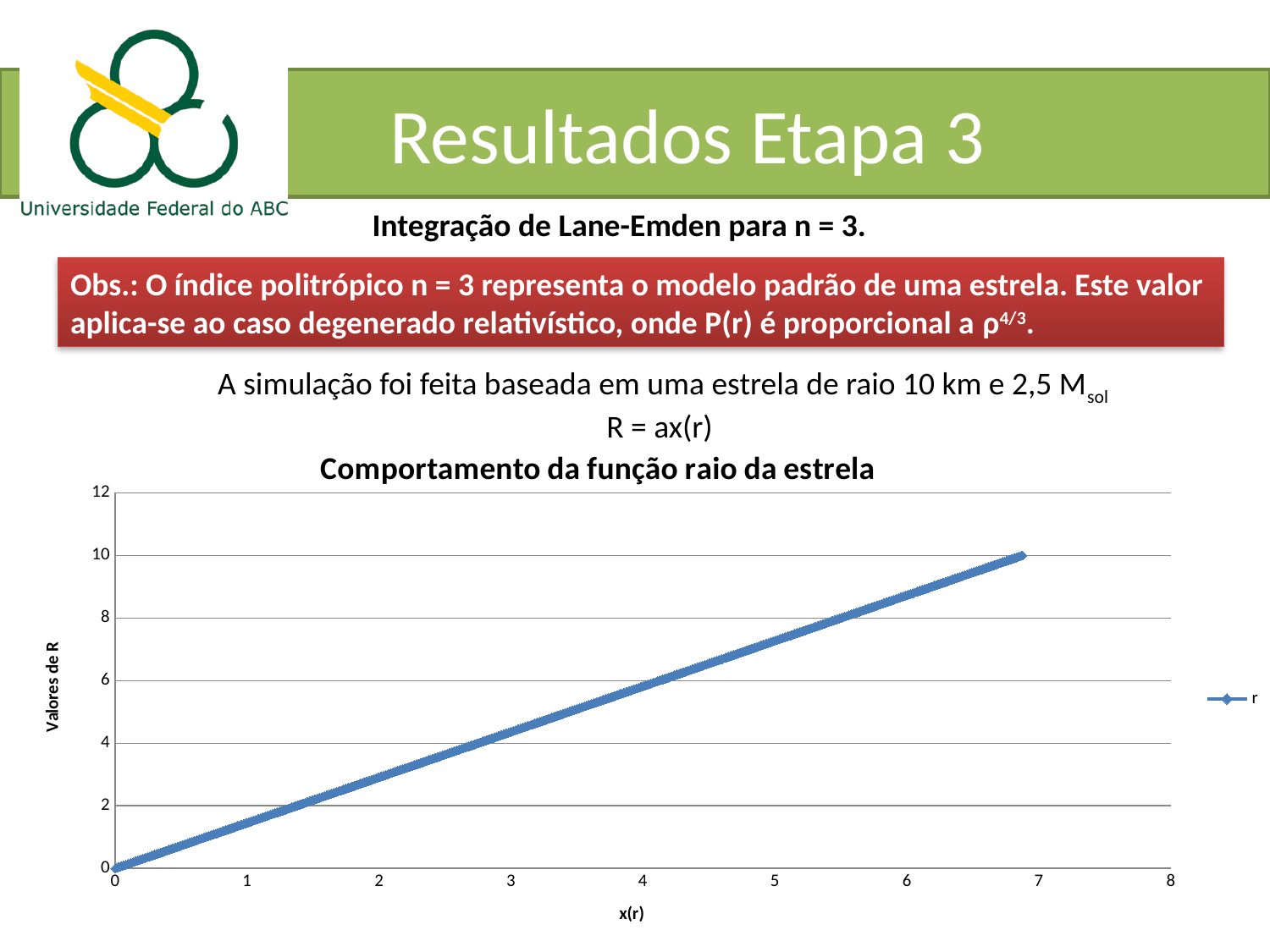
Is the value of R at x(r) = 5 greater or less than 8? less Is the value of R at x(r) = 6 greater or less than 8? greater Do the values of R rise or fall as x(r) increases? rise Is the value of R at x(r) = 2 greater or less than 4? less What is the title of the chart? Comportamento da função raio da estrela How many series does the legend of the chart list? 1 What kind of chart is shown on the slide? line chart Which is larger, the value of R at x(r) = 6 or at x(r) = 2? x(r) = 6 What is the name of the series shown in the chart legend? r What is the value of R at x(r) = 0? 0